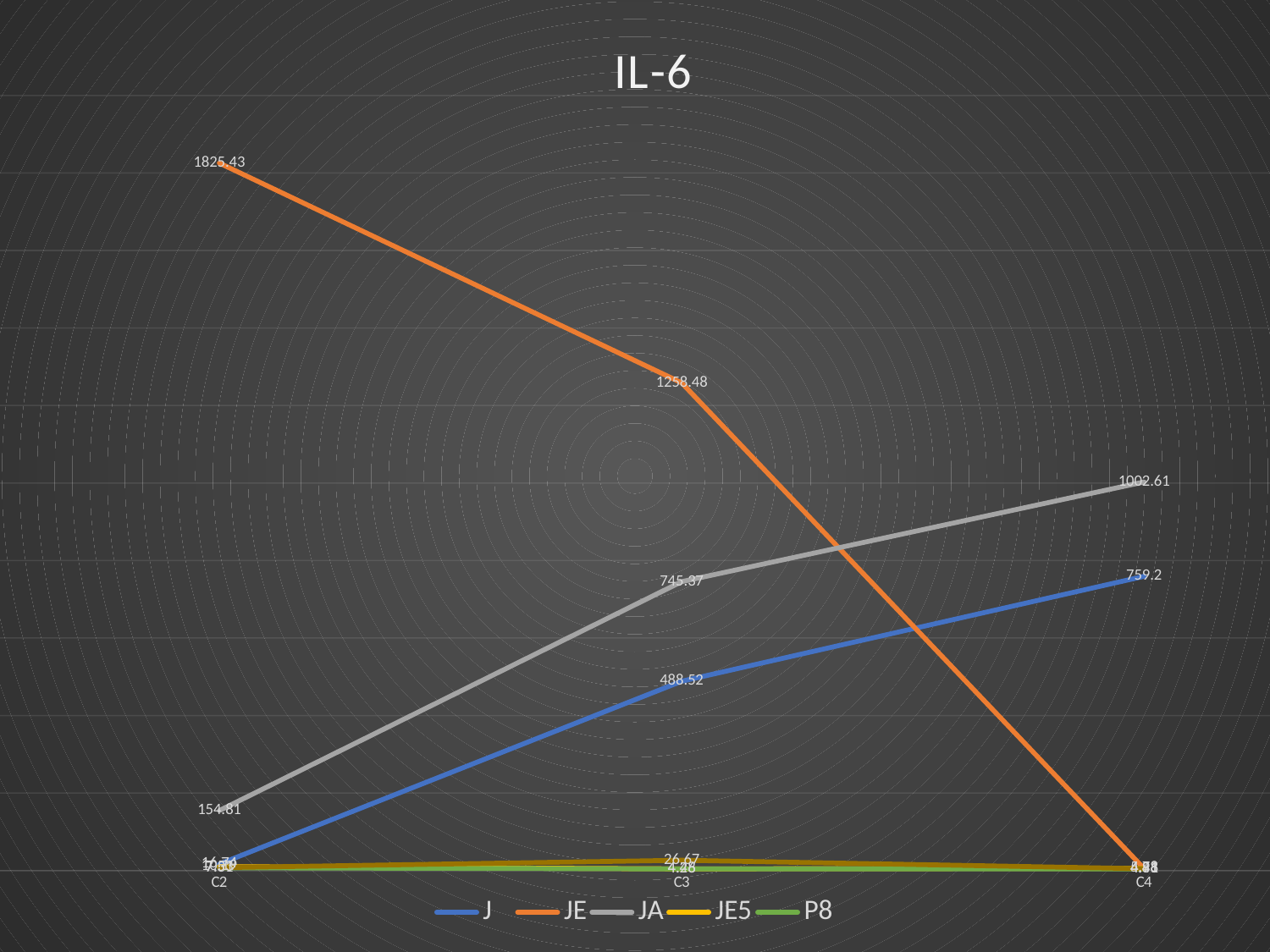
What is the value of JE at C3? 1258.48 How many categories are shown on the x axis? 3 What is the difference between the JA values at C4 and C3? 257.24 What is the value of J at C3? 488.52 Which series has the highest value at C2? JE How many series does the legend list? 5 Does the JE series rise or fall from C2 to C4? fall What is the title of the chart? IL-6 What is the value of JA at C4? 1002.61 What is the value of JA at C2? 154.81 What kind of chart is shown on the slide? line chart What is the value of JE at C2? 1825.43